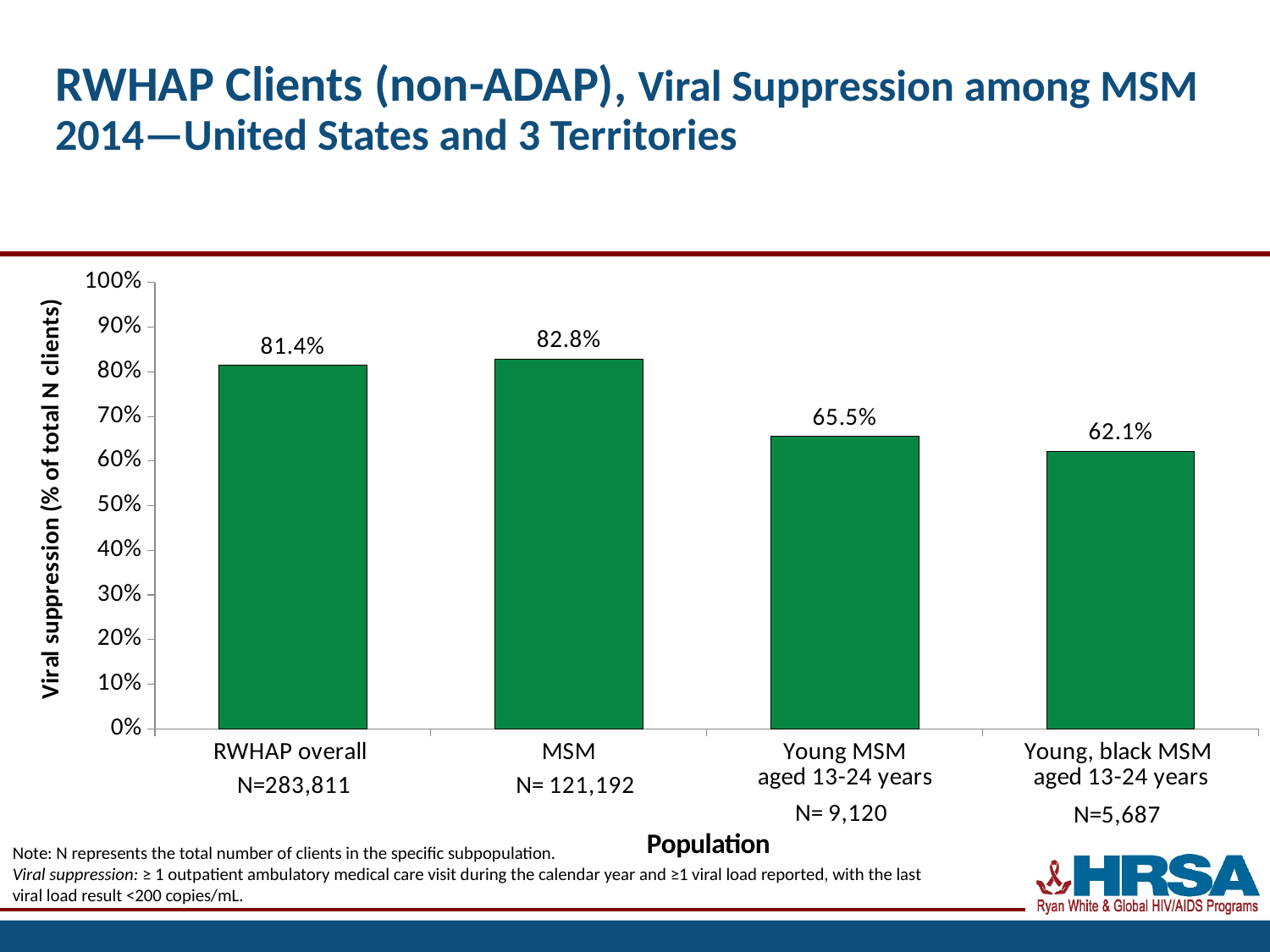
Is the value for Young MSM aged 13-24 years greater or less than 70%? less Which population has the lowest viral suppression percentage? Young, black MSM aged 13-24 years What kind of chart is shown on the slide? Bar chart What is the viral suppression percentage for Young, black MSM aged 13-24 years? 62.1% Which has a higher viral suppression percentage, RWHAP overall or Young MSM aged 13-24 years? RWHAP overall How many populations are shown on the chart? 4 Which population has the highest viral suppression percentage? MSM What is the viral suppression percentage for RWHAP overall? 81.4% What is the label of the y axis? Viral suppression (% of total N clients) What is the viral suppression percentage for MSM? 82.8% What is the viral suppression percentage for Young MSM aged 13-24 years? 65.5% What is the difference in viral suppression between MSM and Young, black MSM aged 13-24 years? 20.7 percentage points